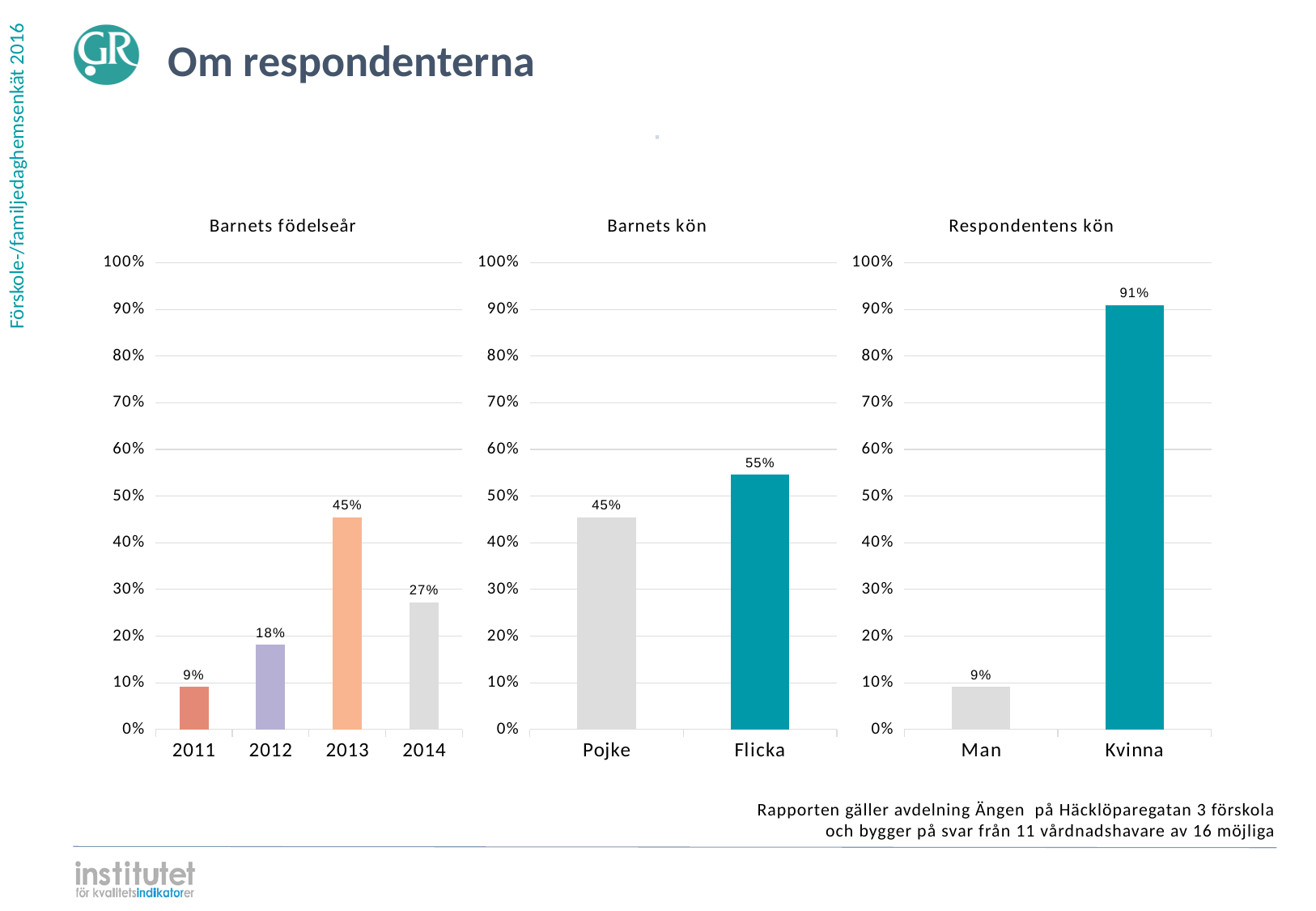
In the 'Barnets kön' chart, which is larger, Pojke or Flicka? Flicka In the 'Barnets kön' chart, what is the value for Pojke? 45% In the 'Barnets kön' chart, what is the difference between Flicka and Pojke? 10% In the 'Barnets födelseår' chart, what is the value for 2013? 45% In the 'Barnets födelseår' chart, how many birth years are shown? 4 In the 'Respondentens kön' chart, what is the value for Kvinna? 91% In the 'Respondentens kön' chart, is the value for Man greater or less than 20%? less In the 'Barnets födelseår' chart, what is the difference between the values for 2014 and 2012? 9% In the 'Barnets födelseår' chart, which birth year has the lowest value? 2011 In the 'Barnets födelseår' chart, which birth year has the highest value? 2013 What is the title of the leftmost chart on the slide? Barnets födelseår What kind of chart is the 'Respondentens kön' chart? Bar chart